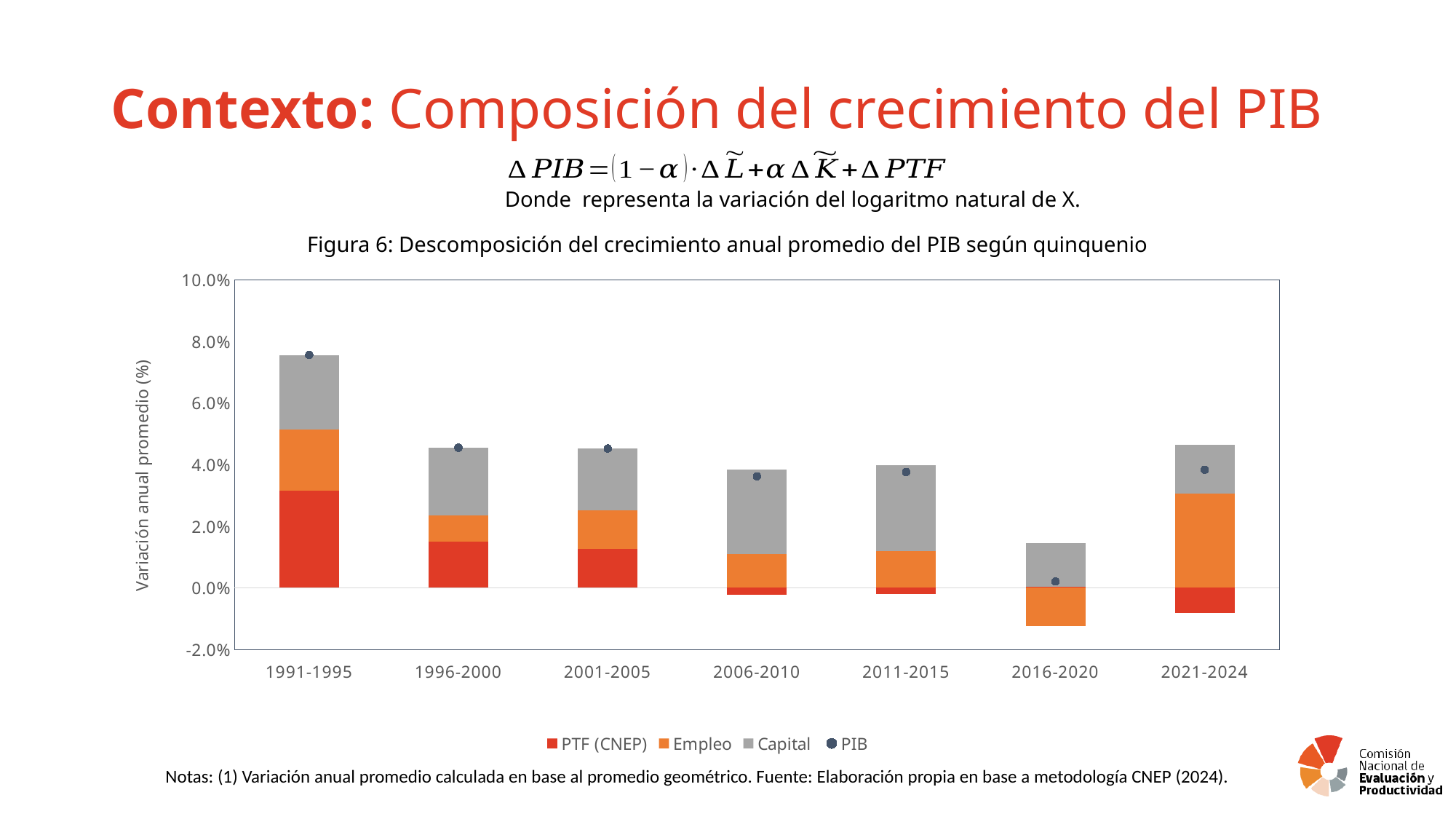
Is the PIB value for 2016-2020 greater or less than 2.0%? less Which quinquenio has the highest PIB value (dot marker) in the chart? 1991-1995 Is the PIB value for 1991-1995 greater or less than 6.0%? greater What kind of chart is shown in Figura 6? stacked bar chart Which is larger, the Empleo value for 2021-2024 or the Empleo value for 1996-2000? 2021-2024 Is the PTF (CNEP) value for 1991-1995 greater or less than 2.0%? greater Which quinquenio has the lowest PIB value (dot marker) in the chart? 2016-2020 Which is larger, the PIB value for 1991-1995 or the PIB value for 2016-2020? 1991-1995 How many quinquenio categories are shown on the x axis of the chart? 7 Does the PIB value generally rise or fall from 1991-1995 to 2016-2020? fall What is the label of the vertical axis of the chart? Variación anual promedio (%) How many series does the chart's legend list? 4